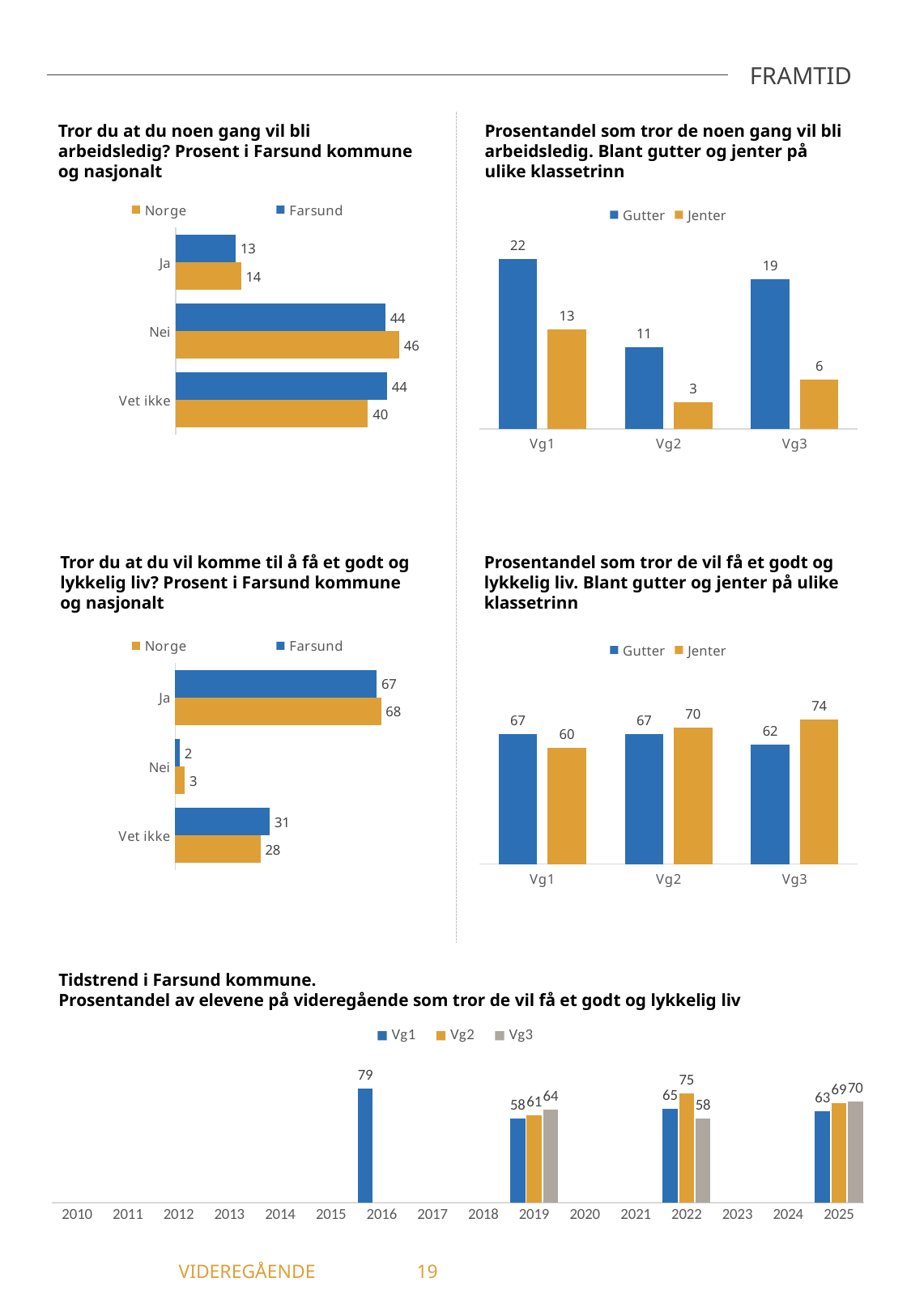
In the middle-left chart (Tror du at du vil komme til å få et godt og lykkelig liv?), what is the value for Norge for 'Ja'? 68 In the middle-right chart (Prosentandel som tror de vil få et godt og lykkelig liv), which class level has the highest value for Jenter? Vg3 In the bottom chart (Tidstrend i Farsund kommune), what is the value for Vg2 in 2022? 75 In the bottom chart (Tidstrend i Farsund kommune), how many series does the legend list? 3 In the top-right chart (Prosentandel som tror de noen gang vil bli arbeidsledig), what is the value for Jenter at Vg2? 3 What type of chart is the bottom chart (Tidstrend i Farsund kommune)? Bar chart In the top-right chart (Prosentandel som tror de noen gang vil bli arbeidsledig), which class level has the highest value for Gutter? Vg1 In the top-right chart (Prosentandel som tror de noen gang vil bli arbeidsledig), how many series does the legend list? 2 In the middle-right chart (Prosentandel som tror de vil få et godt og lykkelig liv), what is the difference between Jenter and Gutter at Vg3? 12 In the middle-left chart (Tror du at du vil komme til å få et godt og lykkelig liv?), which is larger for 'Vet ikke': Norge or Farsund? Farsund In the top-left chart (Tror du at du noen gang vil bli arbeidsledig?), what is the difference between Norge and Farsund for 'Vet ikke'? 4 In the top-left chart (Tror du at du noen gang vil bli arbeidsledig?), what is the value for Farsund for 'Nei'? 44